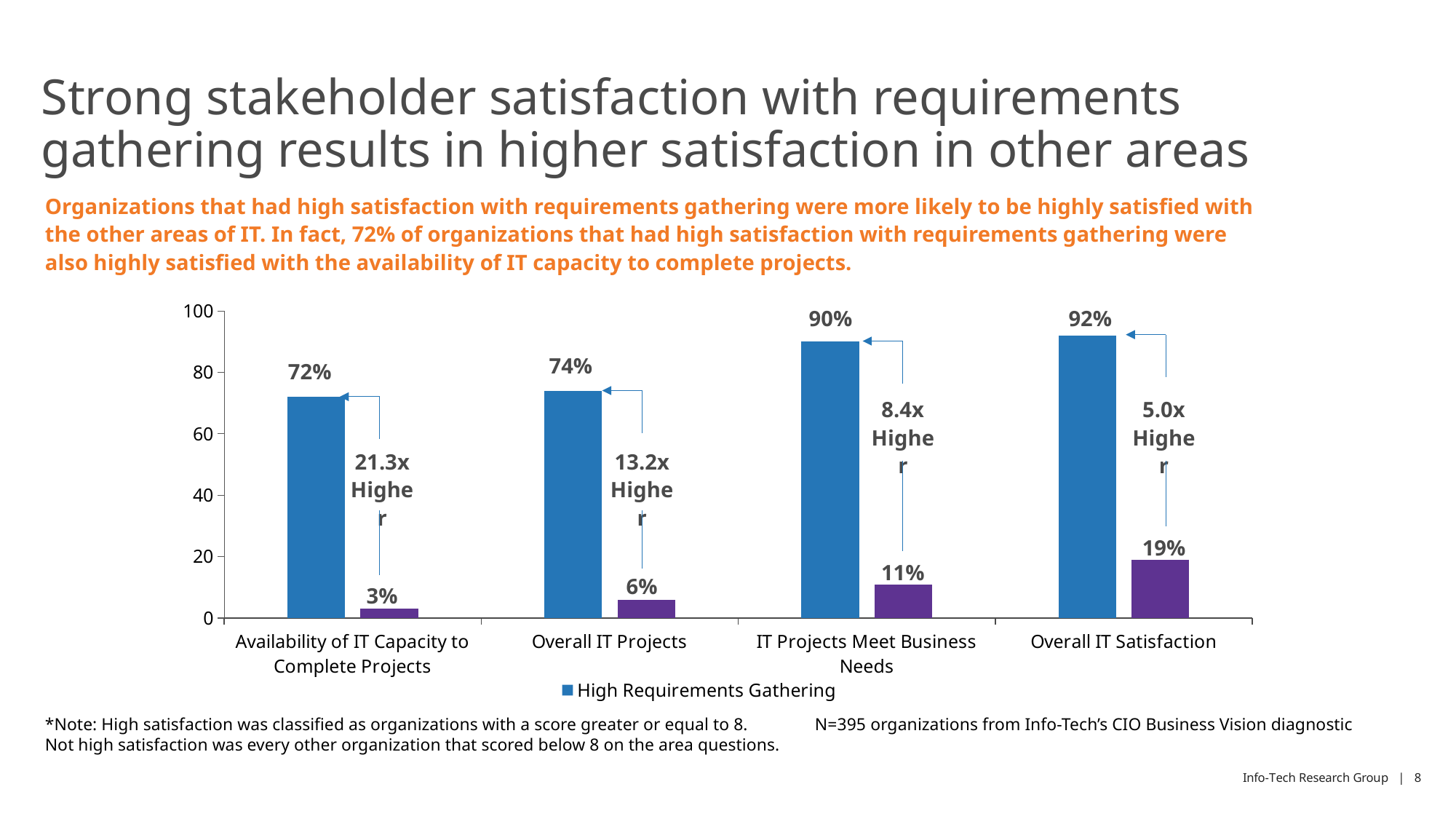
What is the difference between the High Requirements Gathering value and the purple bar value for Overall IT Projects? 68% What kind of chart is shown on the slide? bar chart Which category has the lowest purple bar value? Availability of IT Capacity to Complete Projects How many series does the chart's legend list? 1 Which category has the highest High Requirements Gathering value? Overall IT Satisfaction What multiplier annotation is shown for the Availability of IT Capacity to Complete Projects category? 21.3x Higher What is the value of the purple bar for IT Projects Meet Business Needs? 11% How many categories are shown on the x axis of the chart? 4 What is the value of the High Requirements Gathering bar for Availability of IT Capacity to Complete Projects? 72% Which is larger: the purple bar for Overall IT Satisfaction or the purple bar for Overall IT Projects? Overall IT Satisfaction Do the High Requirements Gathering values rise or fall from left to right across the categories? rise What is the value of the High Requirements Gathering bar for Overall IT Satisfaction? 92%